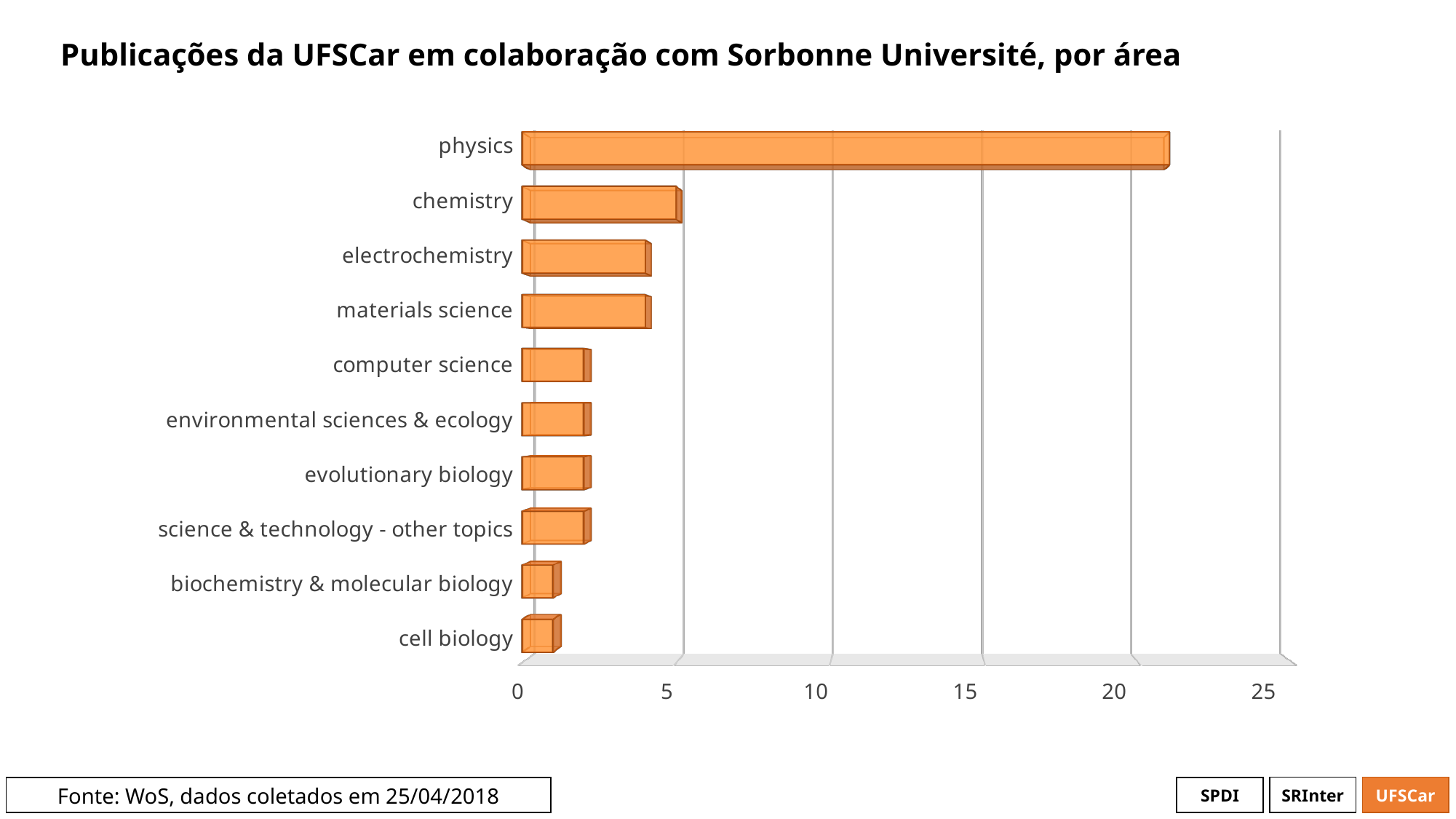
What kind of chart is shown on the slide? bar chart Is the value for physics greater or less than 20? greater Do the bar values decrease or increase going from the top category to the bottom category? decrease Which has more publications, physics or chemistry? physics Is the value for computer science greater or less than 5? less Which has more publications, materials science or evolutionary biology? materials science Is the value for electrochemistry greater or less than 5? less What is the title of the chart? Publicações da UFSCar em colaboração com Sorbonne Université, por área Which has more publications, chemistry or electrochemistry? chemistry Which area has the highest number of publications? physics How many areas (categories) are shown in the chart? 10